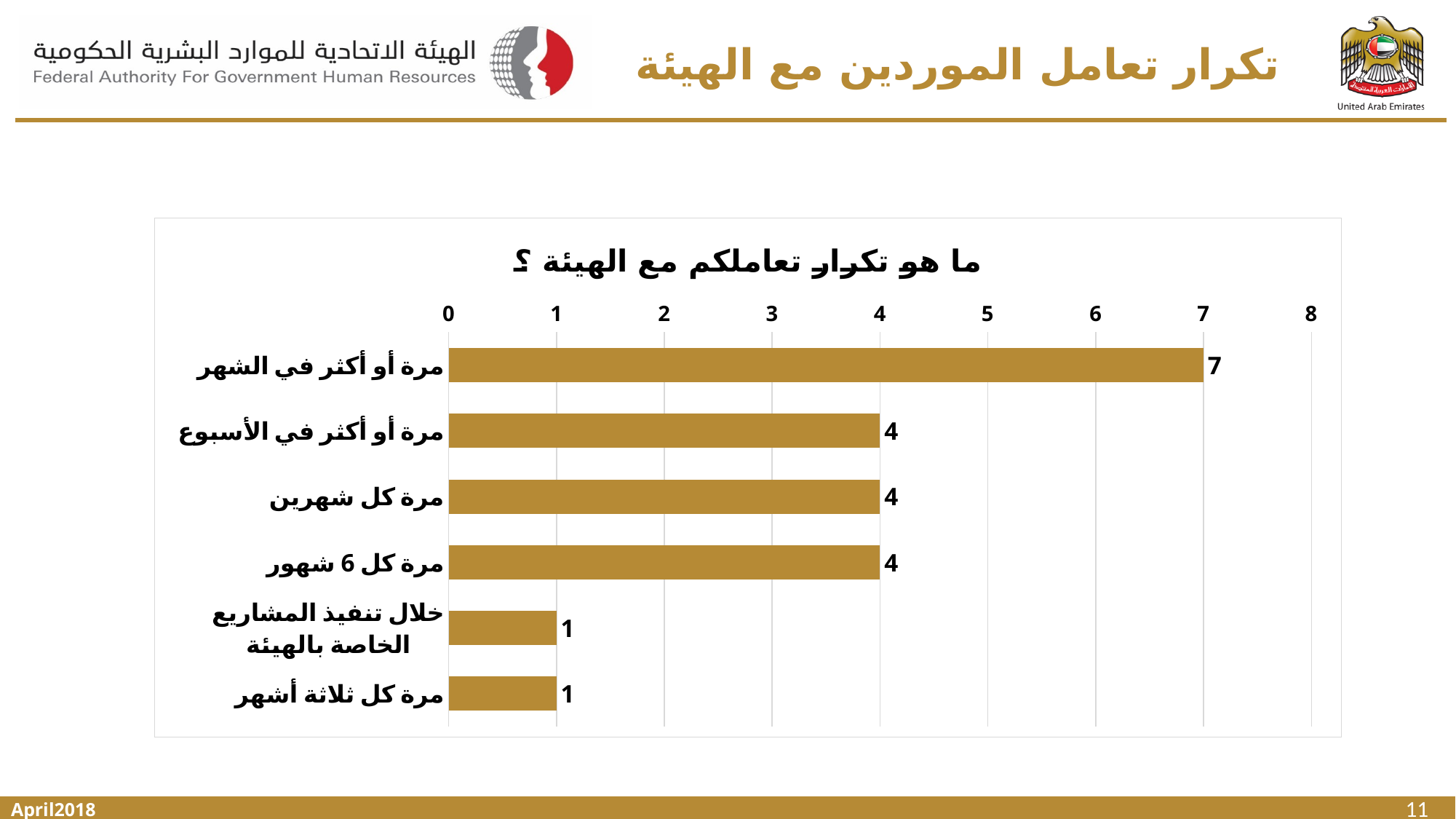
What is the value for "مرة أو أكثر في الأسبوع"? 4 How many categories are shown in the chart? 6 Which category has the highest value? مرة أو أكثر في الشهر What is the title of the chart? ما هو تكرار تعاملكم مع الهيئة ؟ Which is larger, the value for "مرة كل 6 شهور" or the value for "مرة كل ثلاثة أشهر"? مرة كل 6 شهور How many categories have a value of 4? 3 Is the value for "مرة أو أكثر في الشهر" greater or less than 5? greater What is the value for "مرة كل ثلاثة أشهر"? 1 What kind of chart is shown on the slide? bar chart What is the value for "خلال تنفيذ المشاريع الخاصة بالهيئة"? 1 What is the difference between the values for "مرة أو أكثر في الشهر" and "مرة كل شهرين"? 3 What is the value for "مرة أو أكثر في الشهر"? 7